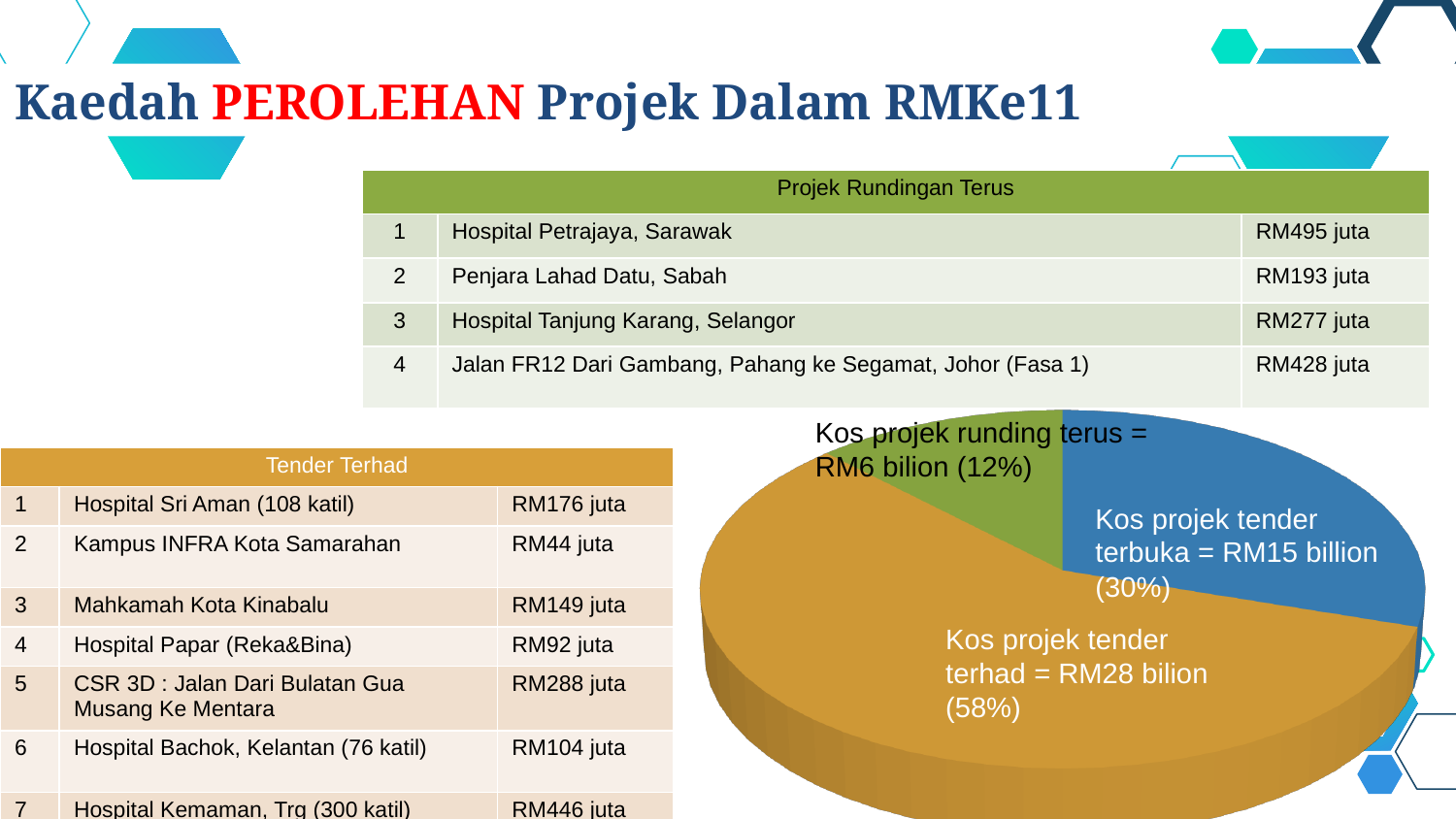
What is the cost of projek tender terhad shown in the pie chart? RM28 bilion What share of the pie chart does projek runding terus represent? 12% What is the difference in percentage share between projek tender terhad and projek tender terbuka in the pie chart? 28% What kind of chart is shown on the slide? pie chart Which category has the largest slice in the pie chart? Kos projek tender terhad What share of the pie chart does projek tender terhad represent? 58% What is the cost of projek runding terus shown in the pie chart? RM6 bilion What share of the pie chart does projek tender terbuka represent? 30% Which category has the smallest slice in the pie chart? Kos projek runding terus What is the cost of projek tender terbuka shown in the pie chart? RM15 billion How many slices does the pie chart have? 3 Which is larger in the pie chart: the cost of projek tender terbuka or projek runding terus? Kos projek tender terbuka